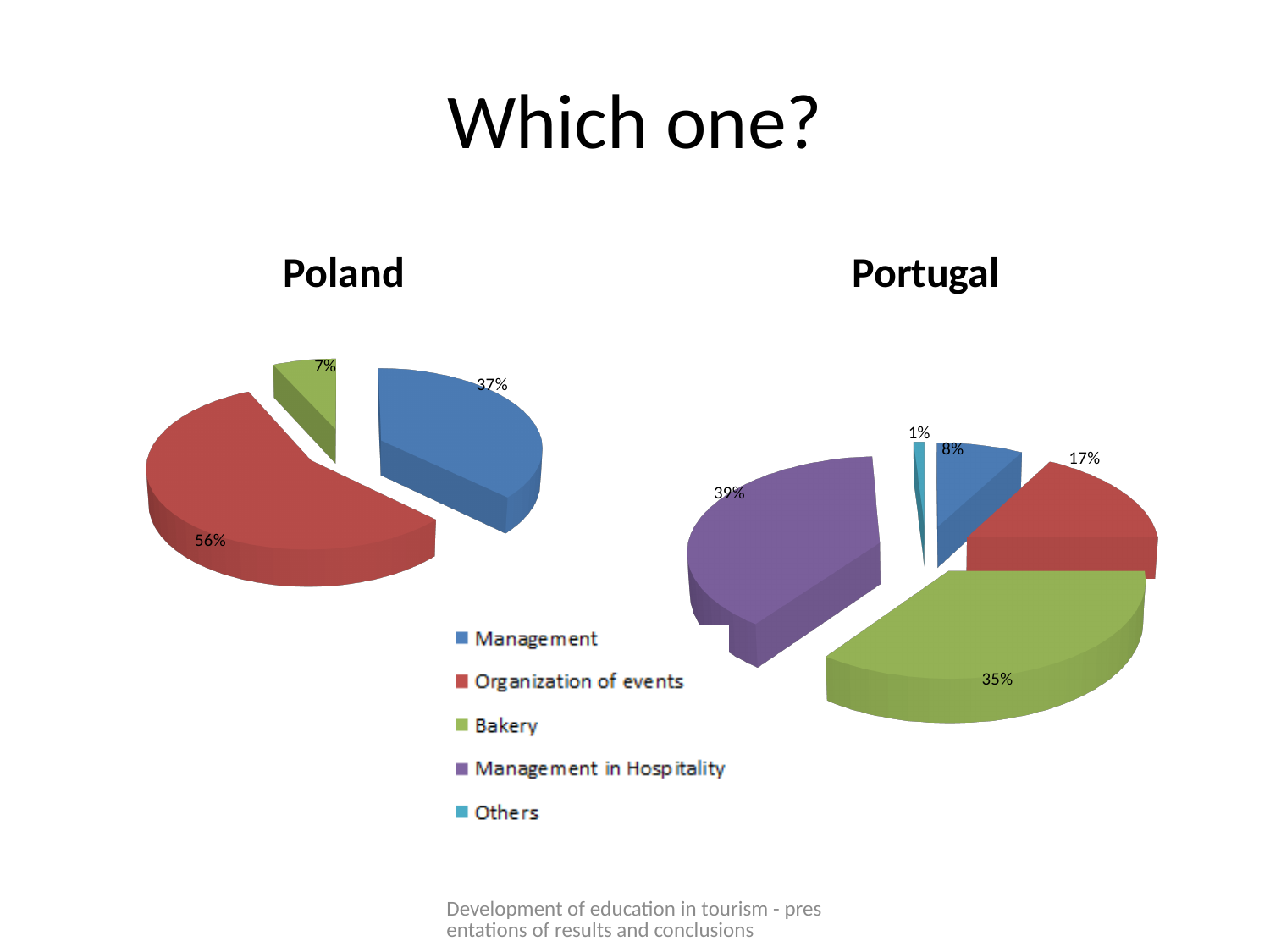
In the Portugal chart, which is larger: Organization of events or Management? Organization of events In the Poland chart, what share does Organization of events have? 56% In the Poland chart, which category has the largest slice? Organization of events In the Portugal chart, what share does Bakery have? 35% In the Poland chart, what share does Management have? 37% In the Poland chart, which category has the smallest slice? Bakery In the Portugal chart, what share does Management in Hospitality have? 39% What is the difference between the Organization of events share in the Poland chart and the Management share in the Poland chart? 19% What kind of chart is used for Poland and Portugal? Pie chart How many entries does the shared legend list? 5 How many slices does the Portugal chart have? 5 In the Portugal chart, which category has the smallest slice? Others